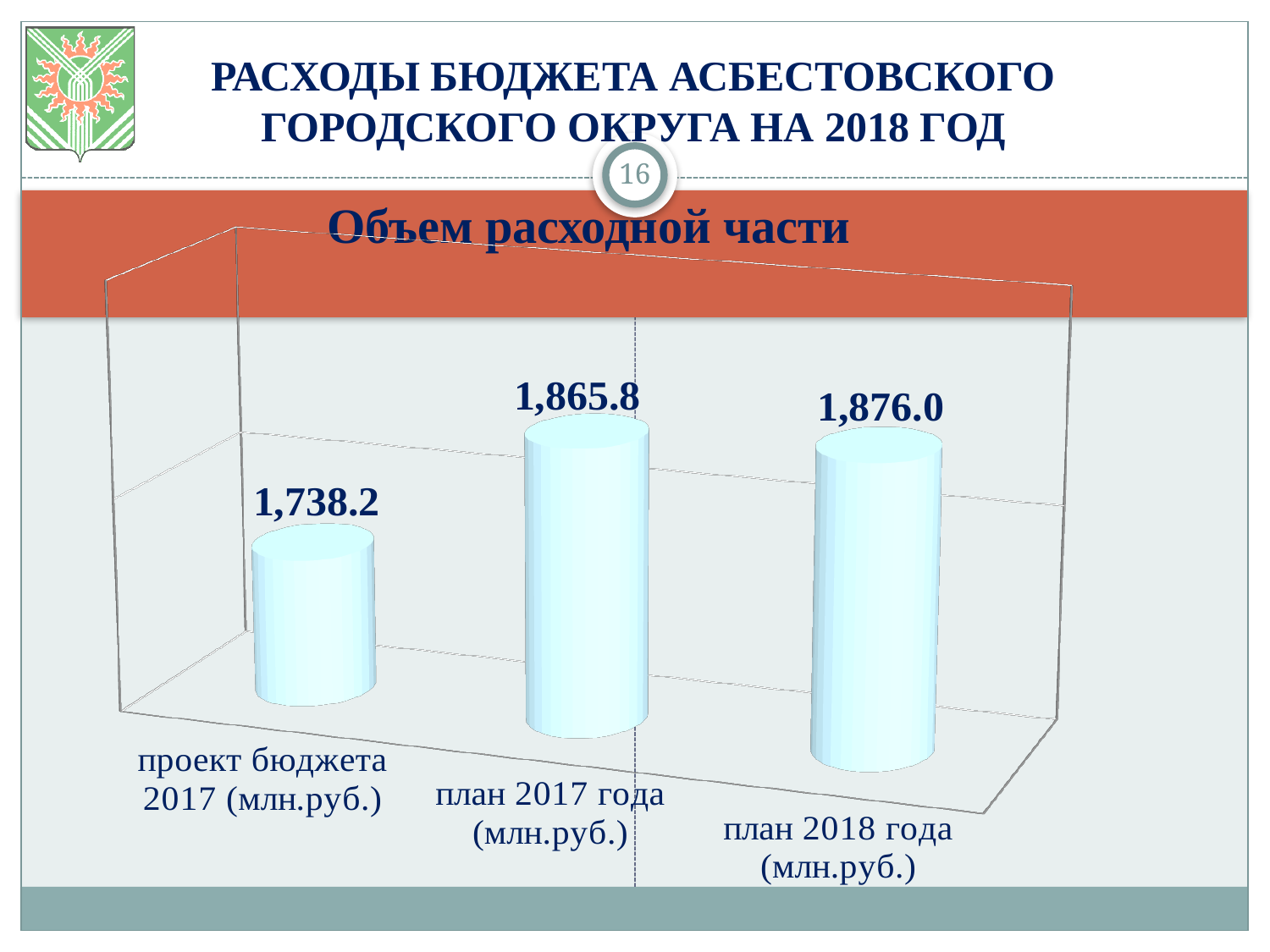
Which category has the highest value? план 2018 года (млн.руб.) What is the difference between план 2018 года and проект бюджета 2017? 137.8 What is the difference between план 2017 года and проект бюджета 2017? 127.6 What is the difference between план 2018 года and план 2017 года? 10.2 Do the values rise or fall from left to right across the categories? rise What is the value for проект бюджета 2017 (млн.руб.)? 1,738.2 How many categories are shown in the chart? 3 What is the value for план 2018 года (млн.руб.)? 1,876.0 What kind of chart is shown on the slide? bar chart Which category has the lowest value? проект бюджета 2017 (млн.руб.) Which is larger, план 2017 года or проект бюджета 2017? план 2017 года What is the value for план 2017 года (млн.руб.)? 1,865.8